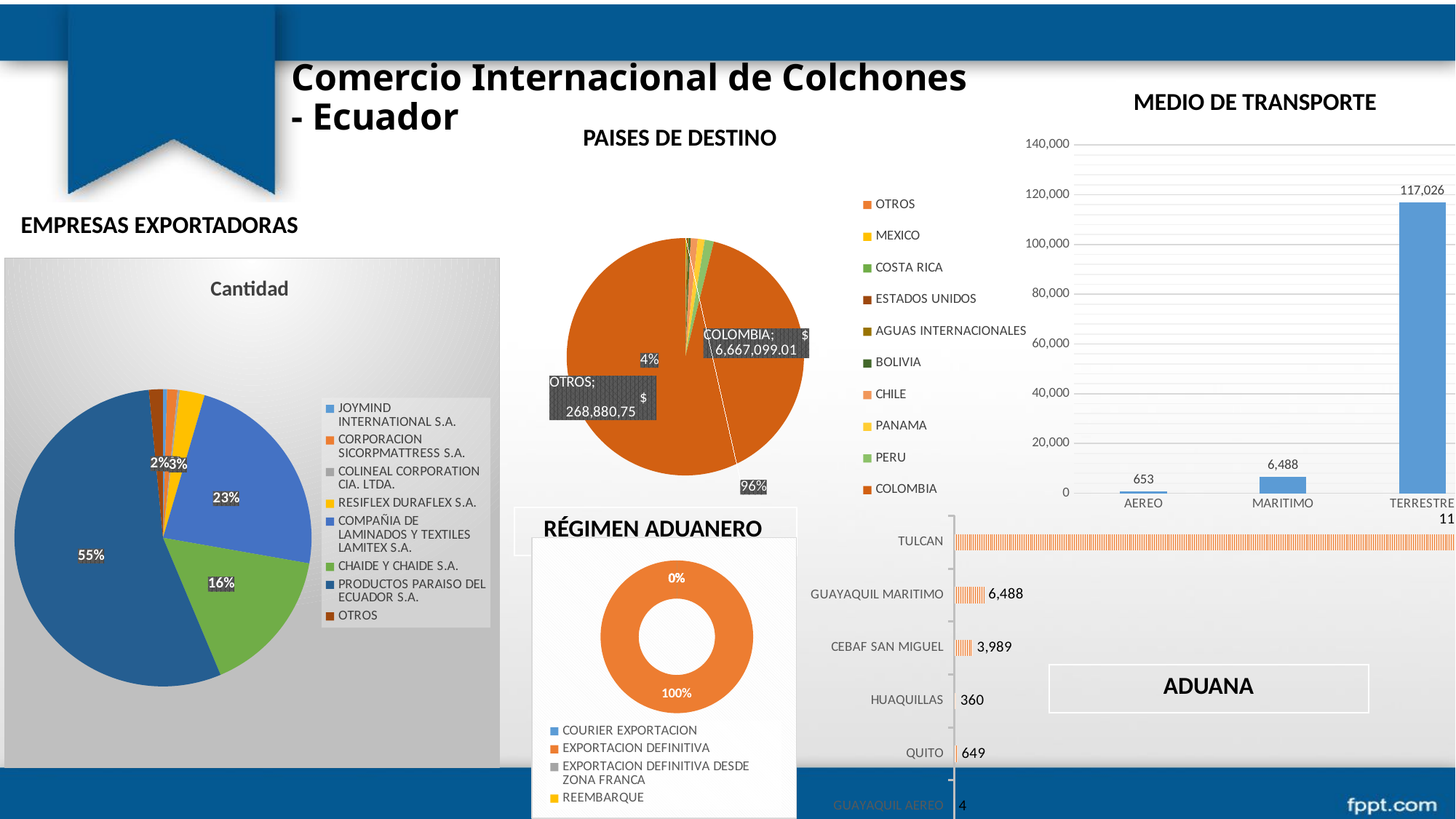
In the PAISES DE DESTINO pie chart, what is the value shown for COLOMBIA? $ 6,667,099.01 In the MEDIO DE TRANSPORTE chart, which mode of transport has the lowest value? AEREO What kind of chart is the RÉGIMEN ADUANERO chart? Donut chart In the MEDIO DE TRANSPORTE chart, what is the value for MARITIMO? 6,488 In the Cantidad pie chart under EMPRESAS EXPORTADORAS, what share does PRODUCTOS PARAISO DEL ECUADOR S.A. have? 55% In the PAISES DE DESTINO pie chart, how many entries does the legend list? 10 In the Cantidad pie chart under EMPRESAS EXPORTADORAS, which is larger: the share for CHAIDE Y CHAIDE S.A. or the share for COMPAÑIA DE LAMINADOS Y TEXTILES LAMITEX S.A.? COMPAÑIA DE LAMINADOS Y TEXTILES LAMITEX S.A. In the MEDIO DE TRANSPORTE chart, what is the difference between the MARITIMO and AEREO values? 5,835 In the MEDIO DE TRANSPORTE chart, what is the value for TERRESTRE? 117,026 In the PAISES DE DESTINO pie chart, what share does COLOMBIA have? 96% In the ADUANA chart, what is the value for CEBAF SAN MIGUEL? 3,989 In the MEDIO DE TRANSPORTE chart, how many categories are shown on the x axis? 3